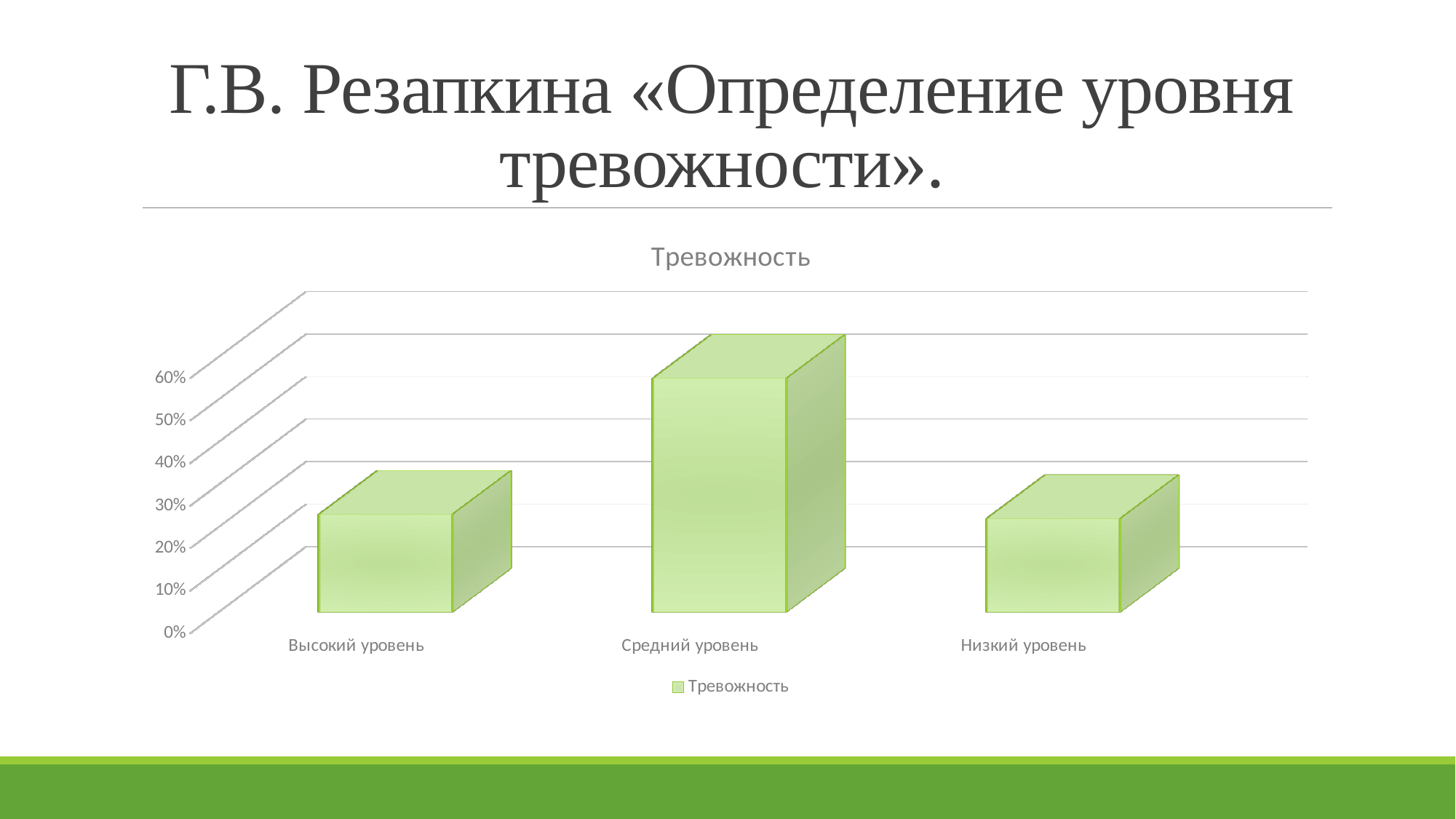
What kind of chart is shown on the slide? bar chart Is the value for Высокий уровень greater or less than 10%? greater Is the value for Высокий уровень greater or less than 40%? less What is the title of the chart? Тревожность Is the value for Низкий уровень greater or less than 40%? less What series name is shown in the chart legend? Тревожность Which is larger, the value for Высокий уровень or the value for Средний уровень? Средний уровень How many series does the legend list? 1 How many categories are shown on the x axis of the chart? 3 Which is larger, the value for Средний уровень or the value for Низкий уровень? Средний уровень Which category has the highest value in the chart? Средний уровень